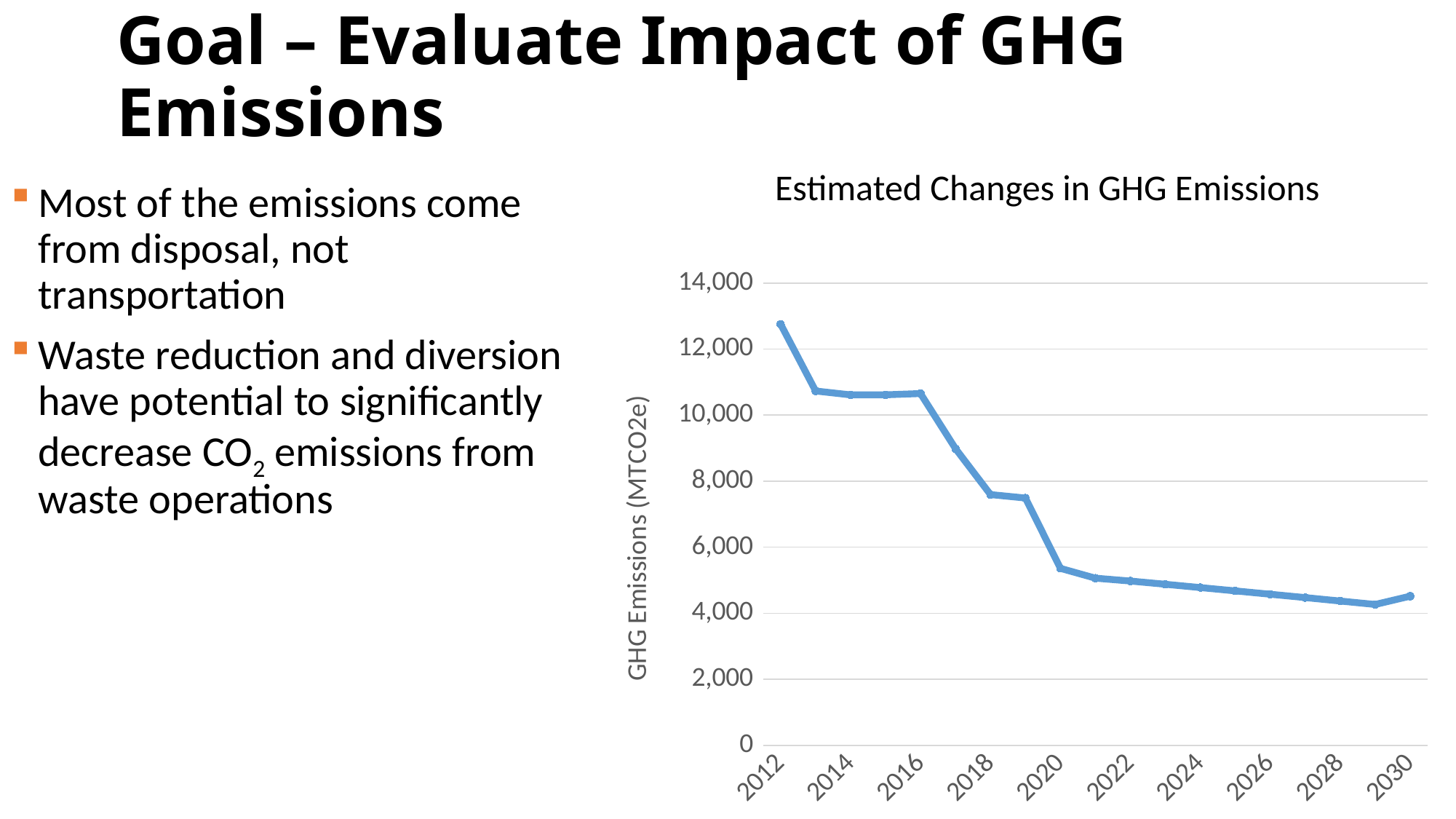
What is the label on the vertical axis of the chart? GHG Emissions (MTCO2e) What kind of chart is shown on the slide? line chart Which year has the larger GHG emissions value, 2016 or 2020? 2016 What is the title of the chart? Estimated Changes in GHG Emissions Is the GHG emissions value for 2020 greater or less than 6,000? less Which year has the highest GHG emissions value in the chart? 2012 Is the GHG emissions value for 2012 greater or less than 12,000? greater Is the GHG emissions value for 2014 greater or less than 10,000? greater Which year has the lowest GHG emissions value in the chart? 2029 Do GHG emissions generally rise or fall from 2012 to 2030 in the chart? fall